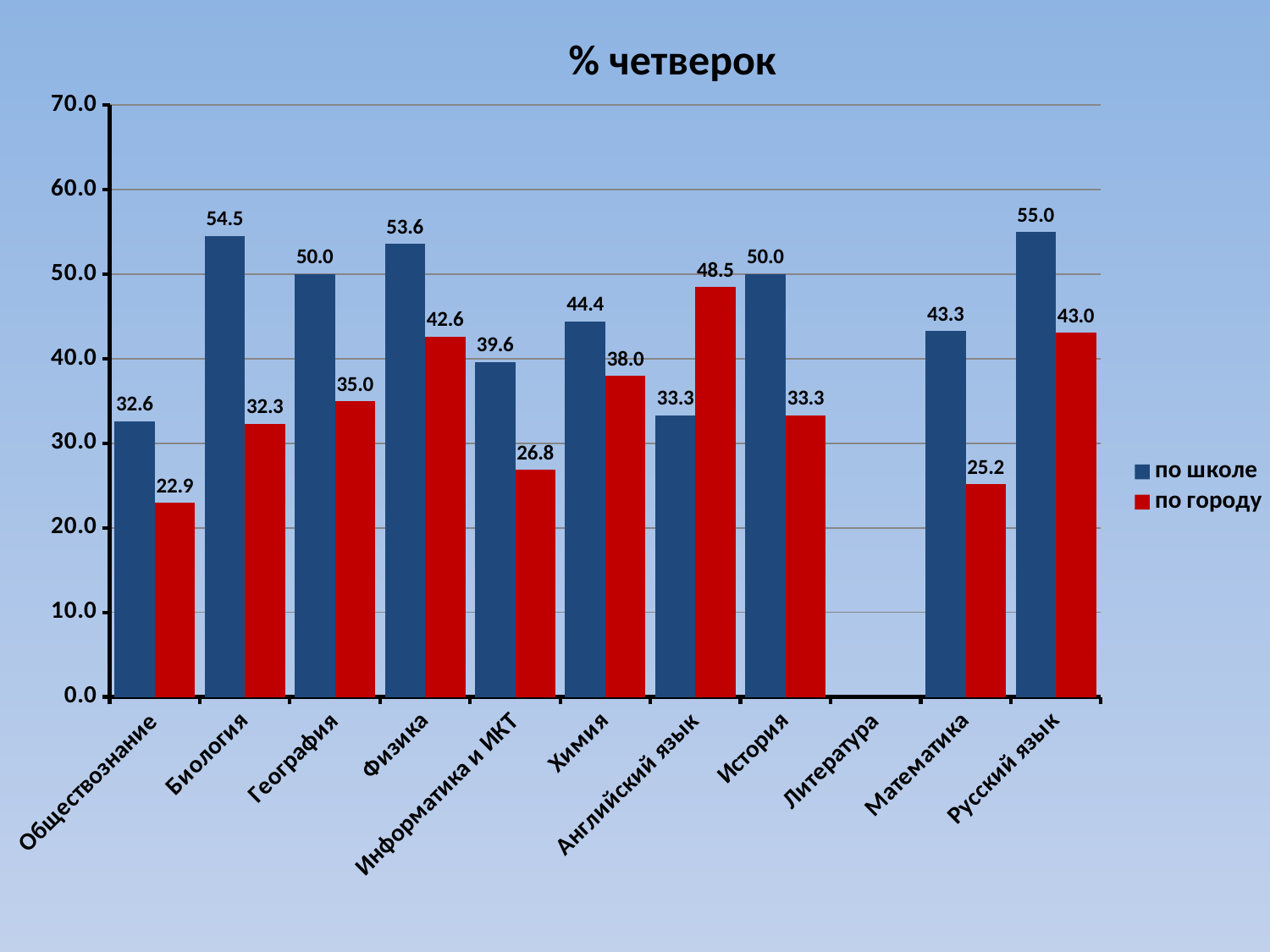
How many categories are shown on the x axis? 11 What is the value for Информатика и ИКТ in the по школе series? 39.6 Which category has the highest value in the по городу series? Английский язык What is the difference between the по школе and по городу values for Физика? 11.0 What is the title of the chart? % четверок Which is larger for Английский язык: the по школе value or the по городу value? по городу How many series does the legend list? 2 Which category has the lowest value in the по городу series? Обществознание Which category has the highest value in the по школе series? Русский язык What is the value for Математика in the по городу series? 25.2 What kind of chart is this? bar chart What is the value for Биология in the по школе series? 54.5